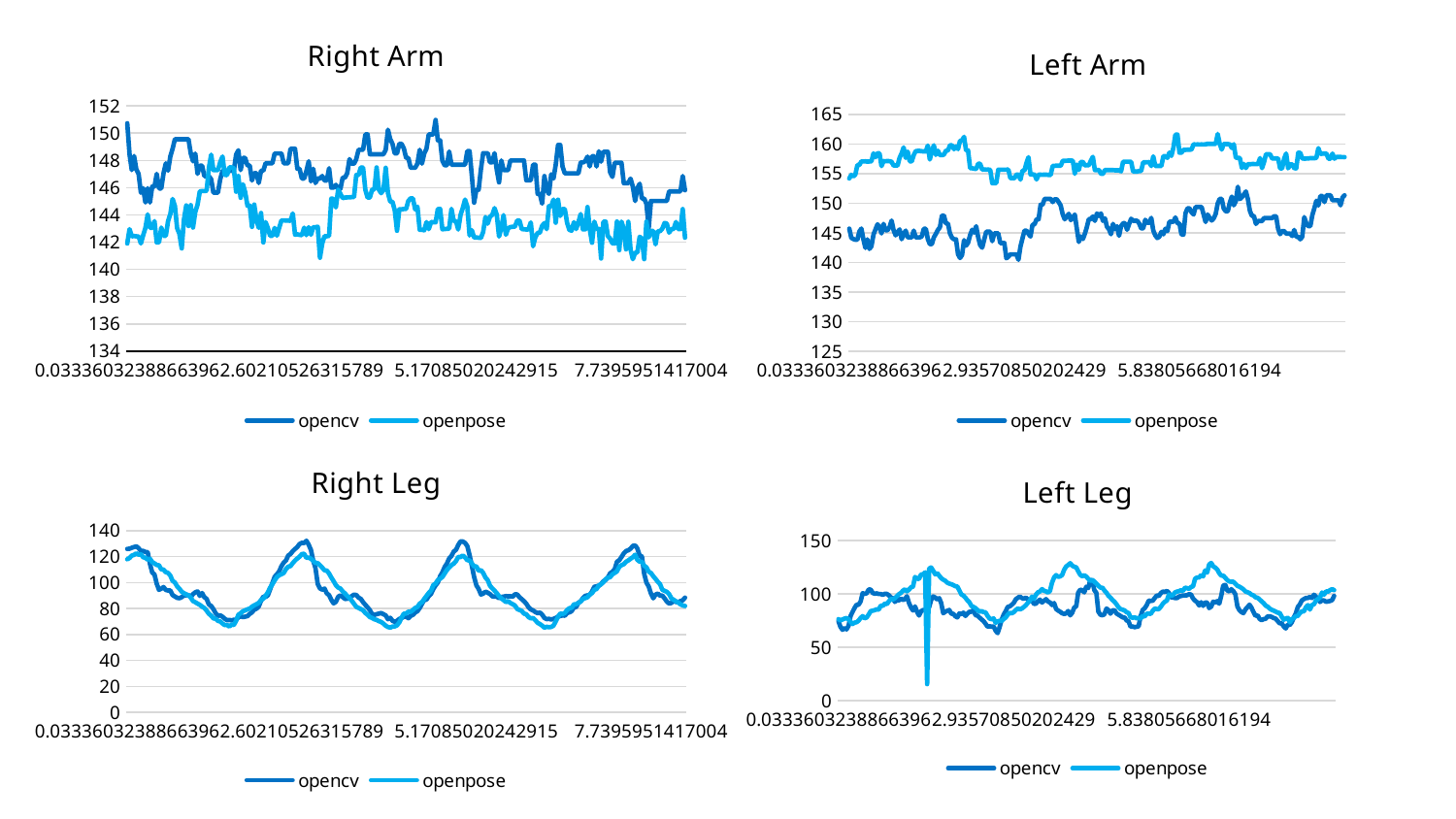
In the Left Arm chart, are the values of the openpose series greater or less than 150? greater How many series does the legend of the Left Arm chart list? 2 In the Left Arm chart, which series has the higher values throughout, opencv or openpose? openpose In the Right Leg chart, is the lowest value of the openpose series greater or less than 60? greater How many charts are shown on the slide? 4 In the Left Arm chart, is the highest value of the opencv series greater or less than 155? less What kind of chart is the Right Arm chart? line chart What are the two series named in the legend of the Right Leg chart? opencv and openpose